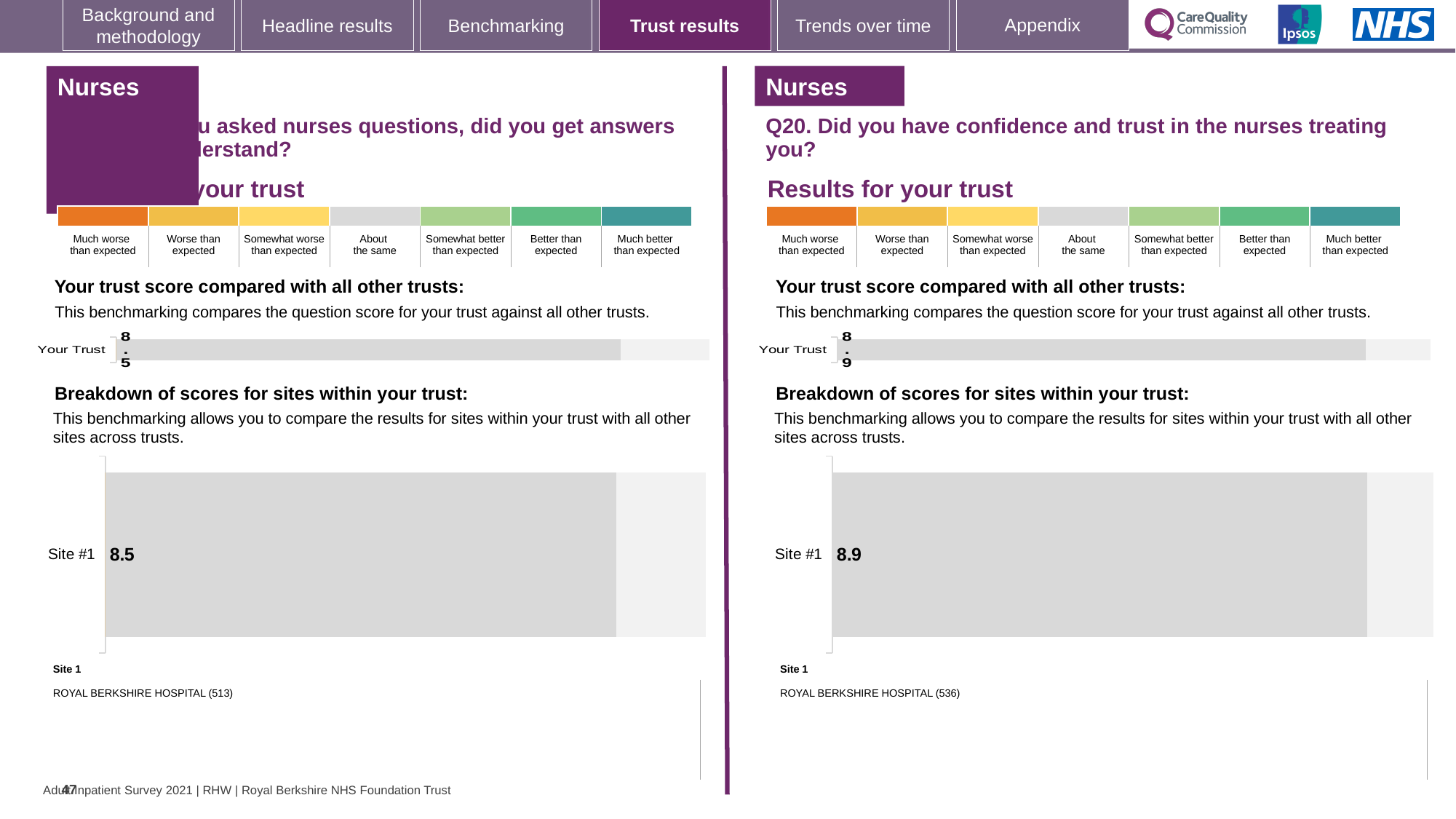
Which hospital is listed as Site 1 on the right half of the slide (Q20)? ROYAL BERKSHIRE HOSPITAL (536) Which hospital is listed as Site 1 on the left half of the slide? ROYAL BERKSHIRE HOSPITAL (513) On the left half of the slide, what is the score shown for Your Trust in the 'Your trust score compared with all other trusts' chart? 8.5 Which is larger: the Your Trust score on the left half of the slide or the Your Trust score on the right half (Q20)? Right half (Q20), 8.9 What type of chart is used to show the Your Trust score on the left half of the slide? Bar chart How many sites are shown in the 'Breakdown of scores for sites within your trust' chart on the left half of the slide? 1 On the right half of the slide (Q20), what is the score shown for Your Trust in the 'Your trust score compared with all other trusts' chart? 8.9 How many sites are shown in the 'Breakdown of scores for sites within your trust' chart on the right half of the slide (Q20)? 1 What is the difference between the Site #1 score on the right half of the slide (Q20) and the Site #1 score on the left half? 0.4 What type of chart is used to show the Site #1 score on the right half of the slide (Q20)? Bar chart In the 'Breakdown of scores for sites within your trust' chart on the right half of the slide (Q20), what is the score for Site #1? 8.9 In the 'Breakdown of scores for sites within your trust' chart on the left half of the slide, what is the score for Site #1? 8.5